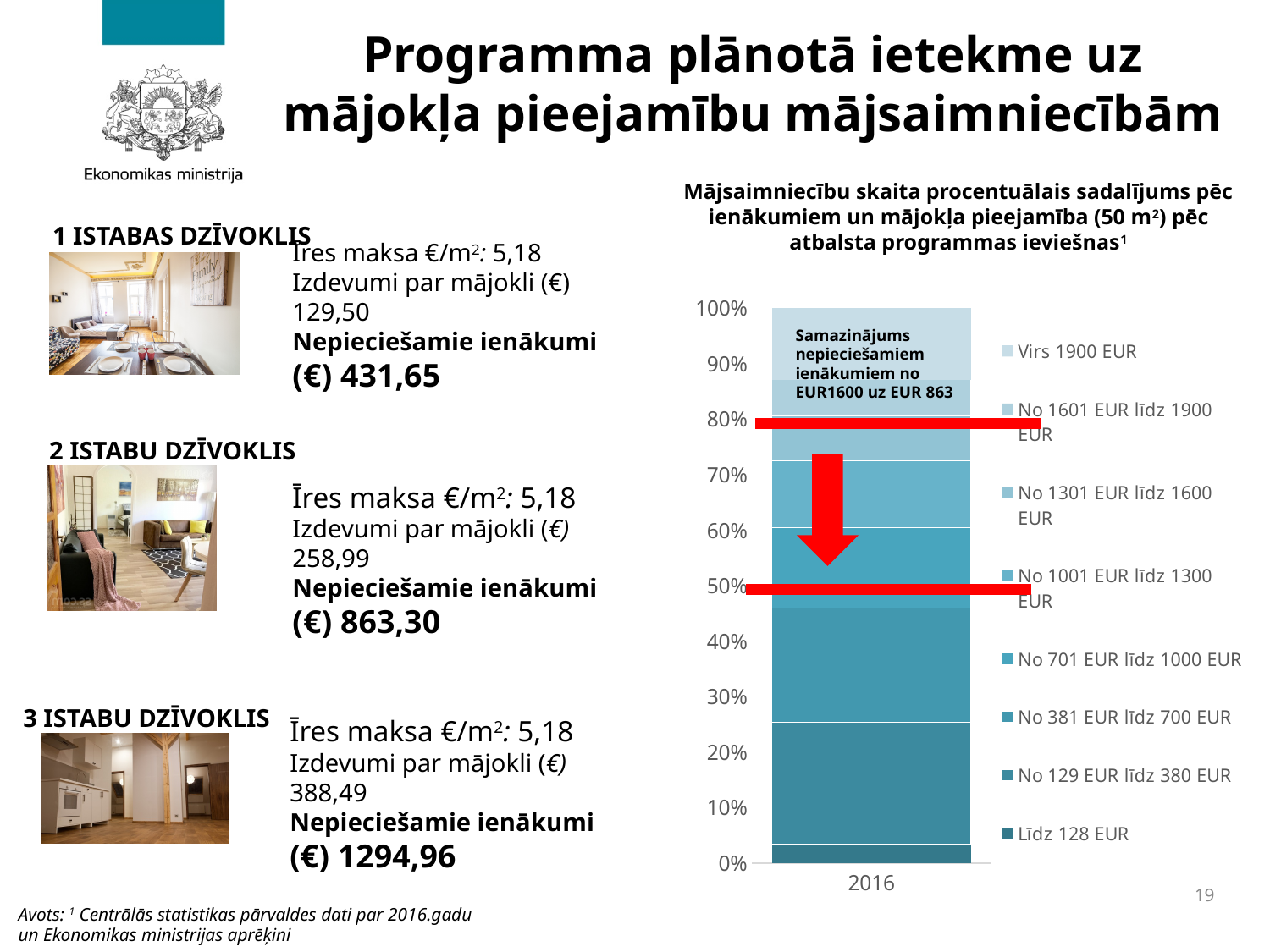
What is the highest value shown on the y axis of the chart? 100% How many series does the chart legend list? 8 What is the category label on the x axis of the chart? 2016 What does the text box inside the chart say the required income is reduced from and to? No EUR1600 uz EUR 863 What kind of chart is shown on the slide? Stacked bar chart Which legend entry is listed first (at the top) in the chart legend? Virs 1900 EUR How many categories are shown on the x axis of the chart? 1 Which income group has the smallest segment in the stacked bar for 2016? Līdz 128 EUR What is the total height of the stacked bar for 2016? 100%